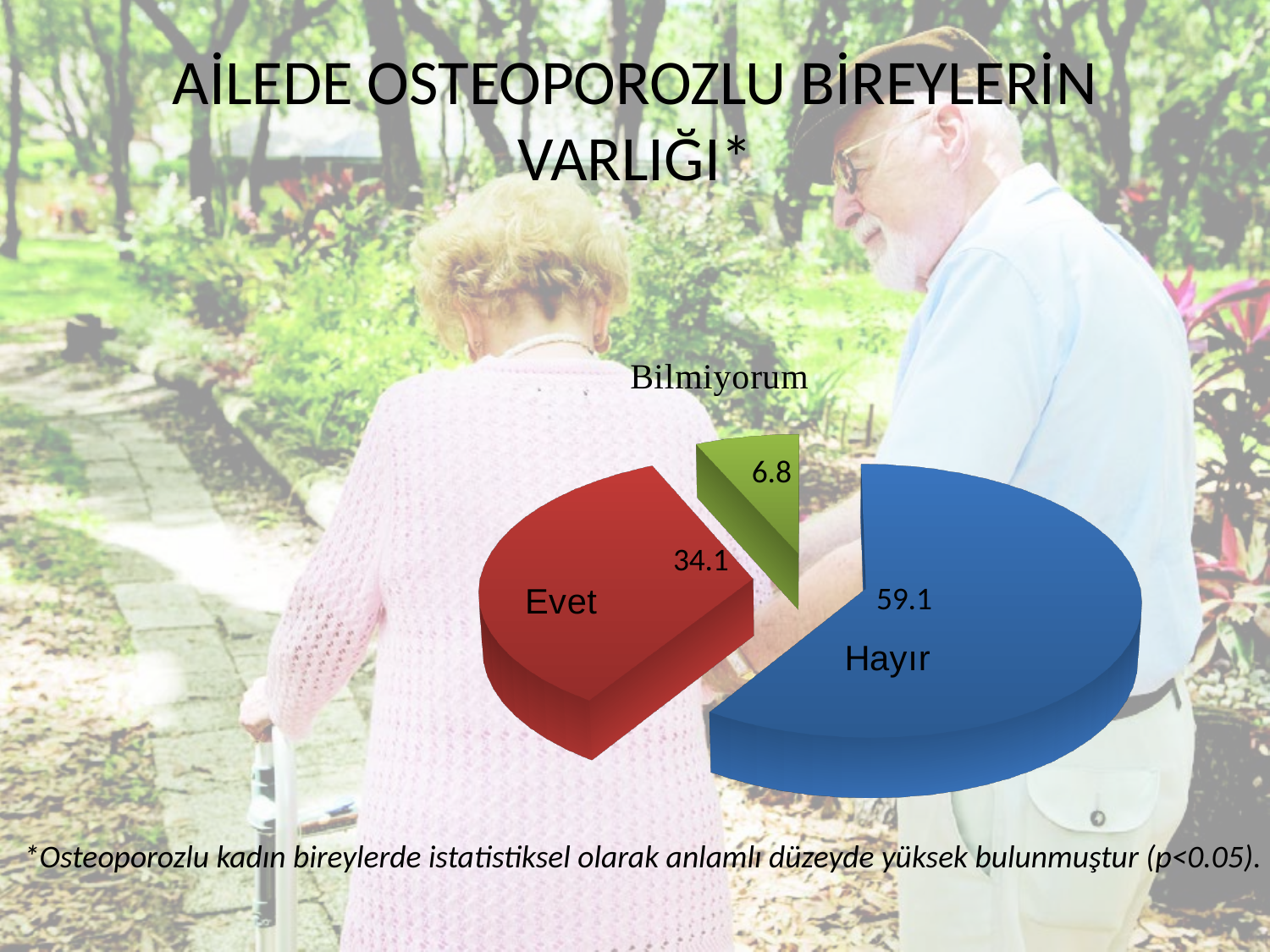
Which is larger, the value for Evet or the value for Bilmiyorum? Evet How many slices does the pie chart have? 3 What is the difference between the values for Hayır and Evet? 25.0 What is the title of the slide containing the chart? AİLEDE OSTEOPOROZLU BİREYLERİN VARLIĞI* What colour is the Hayır slice? blue What is the difference between the values for Evet and Bilmiyorum? 27.3 What is the value for Bilmiyorum? 6.8 What is the value for Hayır? 59.1 What is the value for Evet? 34.1 What kind of chart is shown on the slide? pie chart Which category has the largest slice? Hayır Which category has the smallest slice? Bilmiyorum